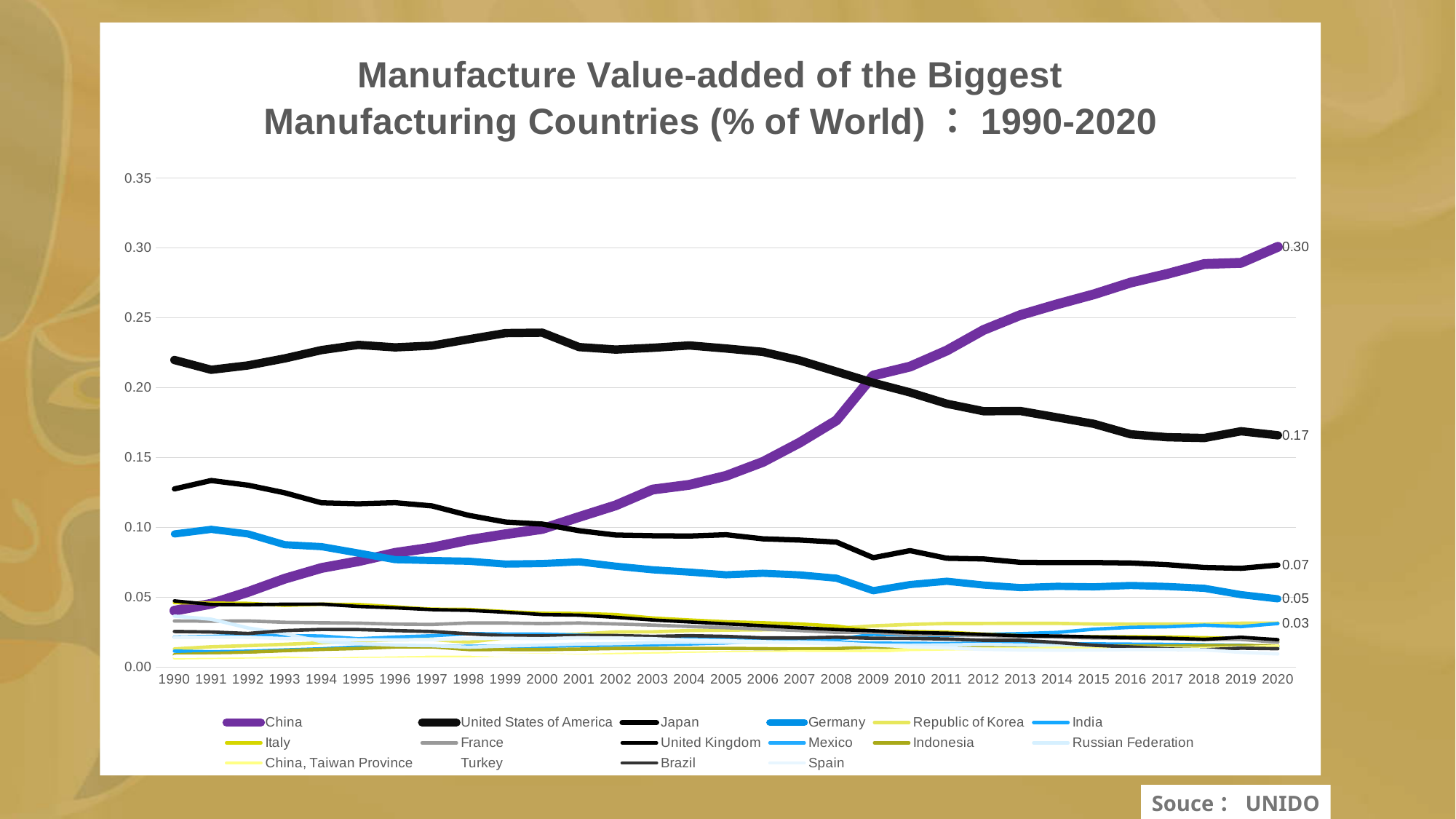
What is the value for the United States of America in 2020? 0.17 What is the value for Japan in 2020? 0.07 Is the value for the United States of America in 1990 greater or less than 0.20? greater Which series has the highest value in 2020? China What kind of chart is shown on the slide? Line chart What is the difference between the values for China and the United States of America in 2020? 0.13 How many years are shown on the x axis? 31 Does the value for the United States of America rise or fall from 1990 to 2020? Fall What is the value for China in 2020? 0.30 What is the value for Germany in 2020? 0.05 Does the value for China rise or fall from 1990 to 2020? Rise How many series does the legend list? 16